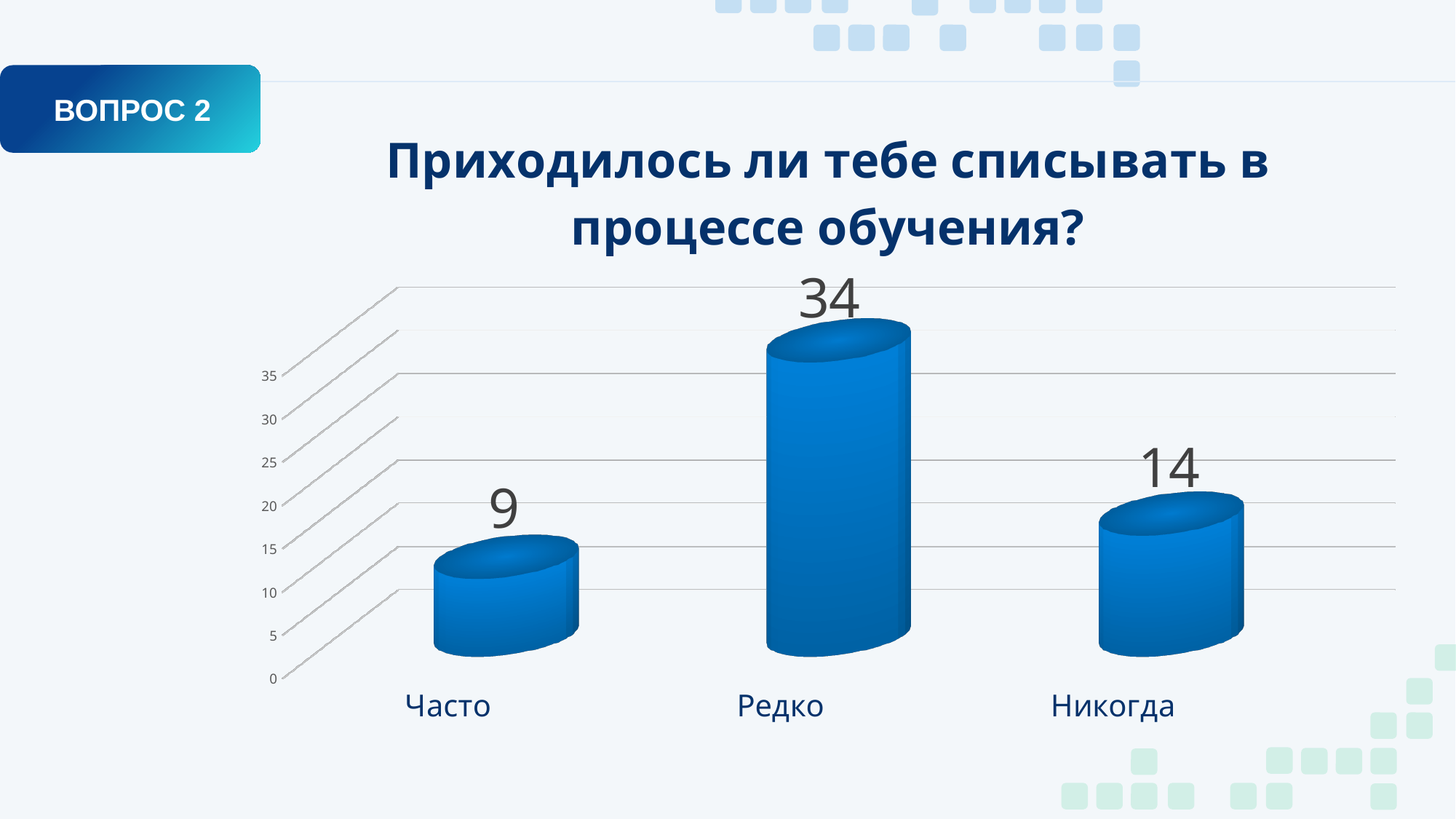
What is the difference between the values for Никогда and Часто? 5 Which category has the highest value? Редко Which category has the lowest value? Часто How many categories are shown in the chart? 3 Is the value for Редко greater or less than 30? greater What kind of chart is shown on the slide? bar chart What is the title of the chart? Приходилось ли тебе списывать в процессе обучения? What is the difference between the values for Редко and Никогда? 20 What is the value for Часто? 9 Which is larger, the value for Часто or the value for Никогда? Никогда What is the value for Никогда? 14 What is the value for Редко? 34